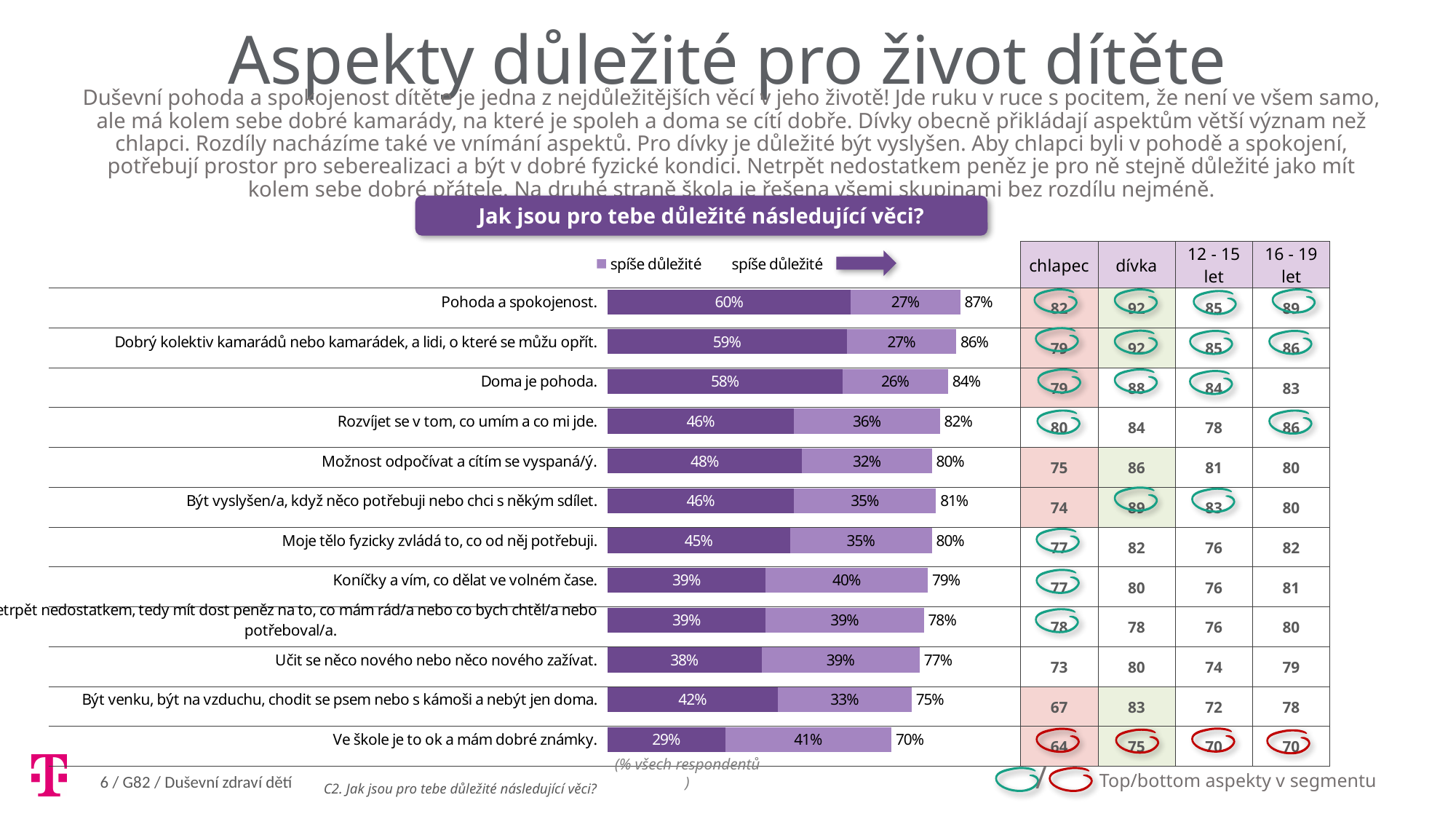
Which category has the lowest total value? Ve škole je to ok a mám dobré známky. Which has the larger dark purple segment: "Možnost odpočívat a cítím se vyspaná/ý." or "Rozvíjet se v tom, co umím a co mi jde."? Možnost odpočívat a cítím se vyspaná/ý. What is the value of the light purple segment for "Ve škole je to ok a mám dobré známky."? 41% What question is shown in the purple box above the chart? Jak jsou pro tebe důležité následující věci? What is the difference between the total for "Pohoda a spokojenost." (87%) and the total for "Ve škole je to ok a mám dobré známky." (70%)? 17 percentage points What is the value of the dark purple segment for "Pohoda a spokojenost."? 60% What kind of chart is shown on the slide? Stacked bar chart Which category has the highest total value? Pohoda a spokojenost. What is the total shown at the end of the bar for "Doma je pohoda."? 84% What is the value of the light purple segment for "Koníčky a vím, co dělat ve volném čase."? 40% How many categories (bars) are shown in the chart? 12